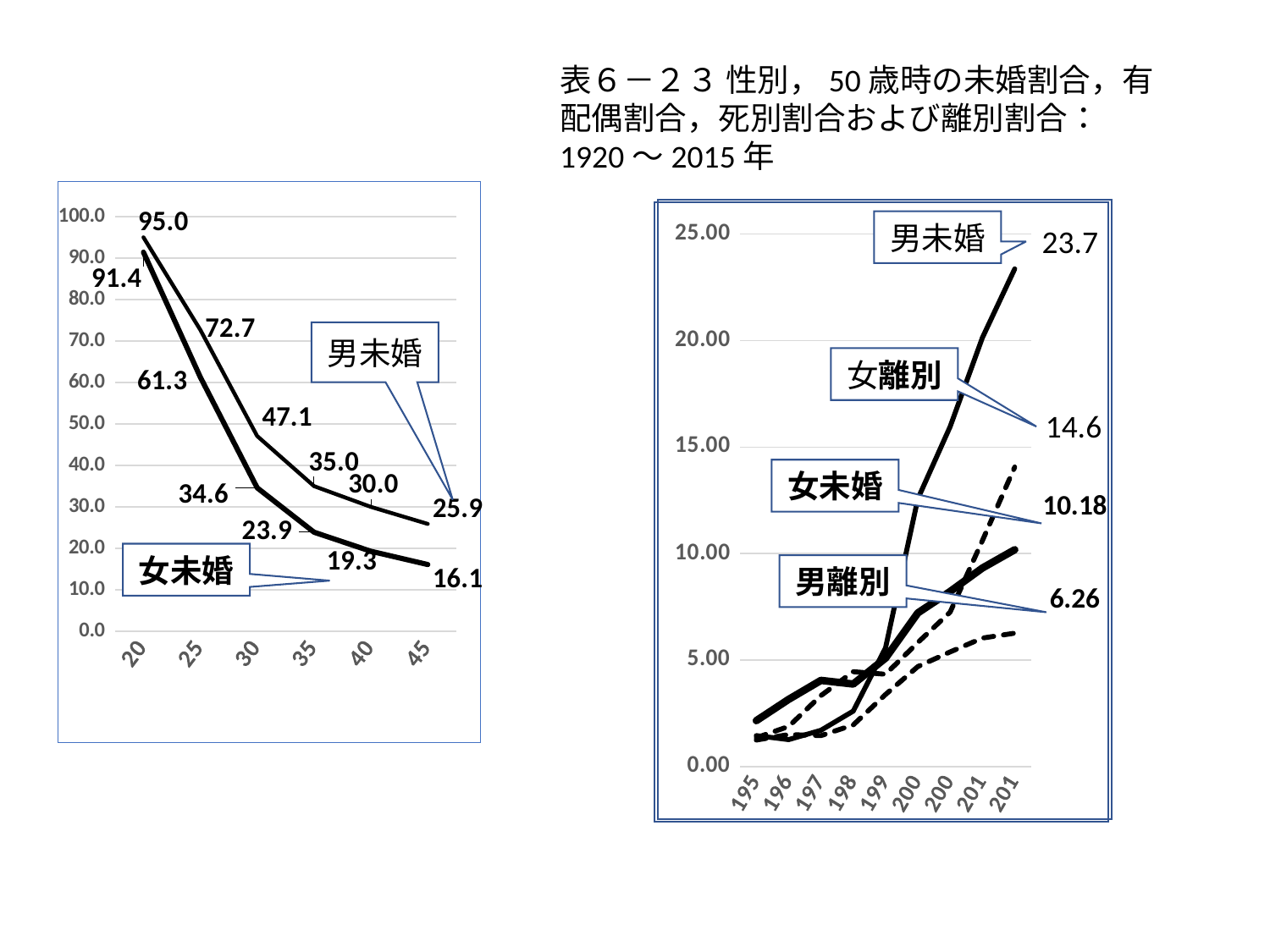
On the left chart, what is the value for 男未婚 at age 35? 35.0 On the left chart, what is the difference between 男未婚 and 女未婚 at age 30? 12.5 On the right chart, which series has the highest final value? 男未婚 What kind of chart is the left chart? line chart On the left chart, which series is higher at age 25, 男未婚 or 女未婚? 男未婚 On the left chart, how many age categories are shown on the x axis? 6 On the left chart, what is the value for 男未婚 at age 20? 95.0 On the right chart, how many series are labelled? 4 On the right chart, what is the final labelled value for 男未婚? 23.7 On the left chart, what is the value for 女未婚 at age 45? 16.1 On the right chart, what is the final labelled value for 男離別? 6.26 On the left chart, do the values for 女未婚 rise or fall as age increases? fall